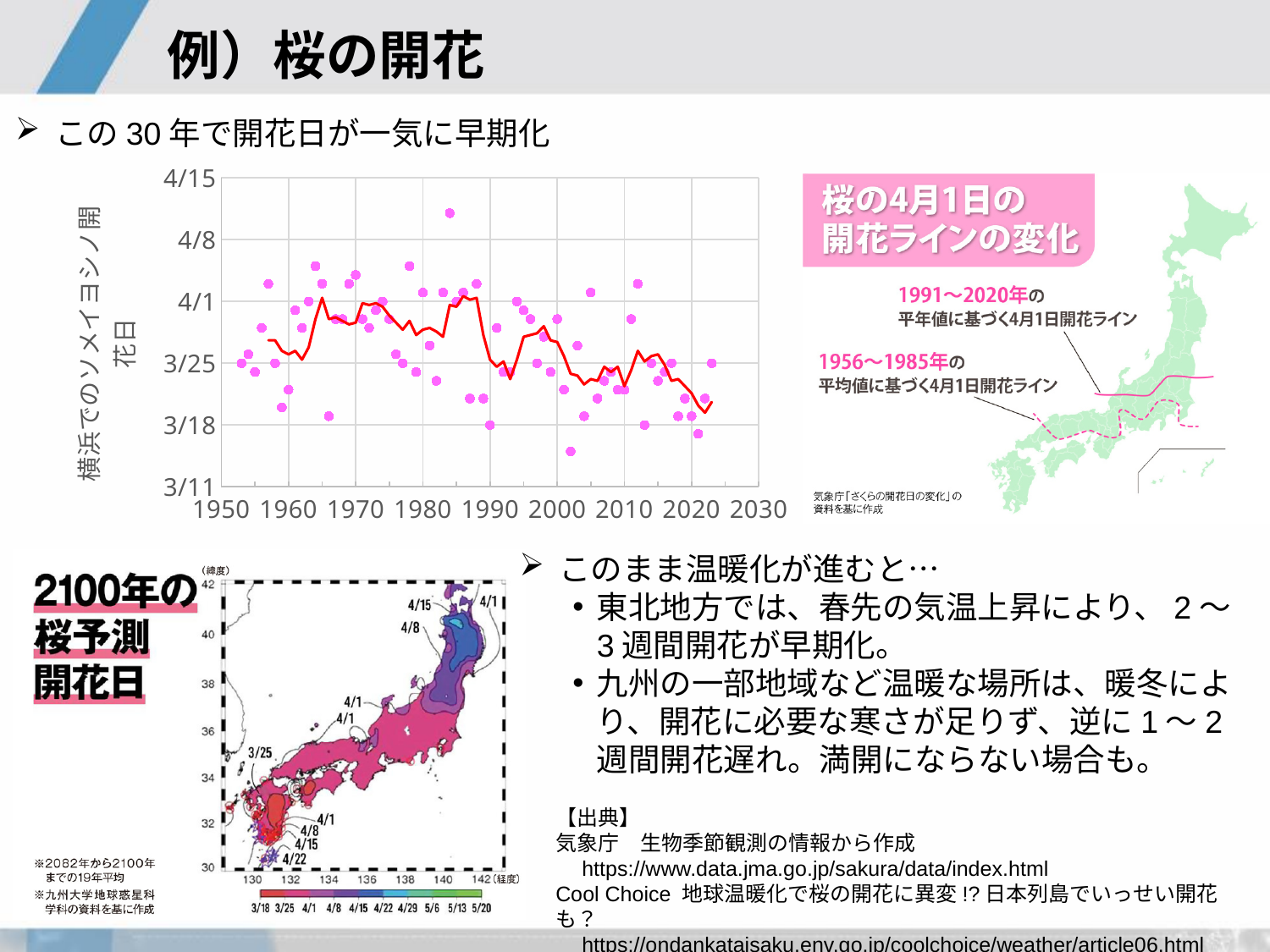
In the Yokohama flowering-date chart, do the flowering dates generally get earlier or later as the years go from 1950 to 2030? earlier In the Yokohama flowering-date chart, is the value for the point around 1960 earlier or later than 3/25? earlier What is the last year tick on the horizontal axis of the Yokohama flowering-date chart? 2030 In the Yokohama flowering-date chart, is the value for the point around 1965 earlier or later than 4/1? later What is the first year tick on the horizontal axis of the Yokohama flowering-date chart? 1950 What is the earliest date shown on the vertical axis of the Yokohama flowering-date chart? 3/11 What is the label of the vertical axis of the Yokohama flowering-date chart? 横浜でのソメイヨシノ開花日 What kind of chart is the chart of Yokohama cherry blossom flowering dates? scatter chart with a trend line What is the latest date shown on the vertical axis of the Yokohama flowering-date chart? 4/15